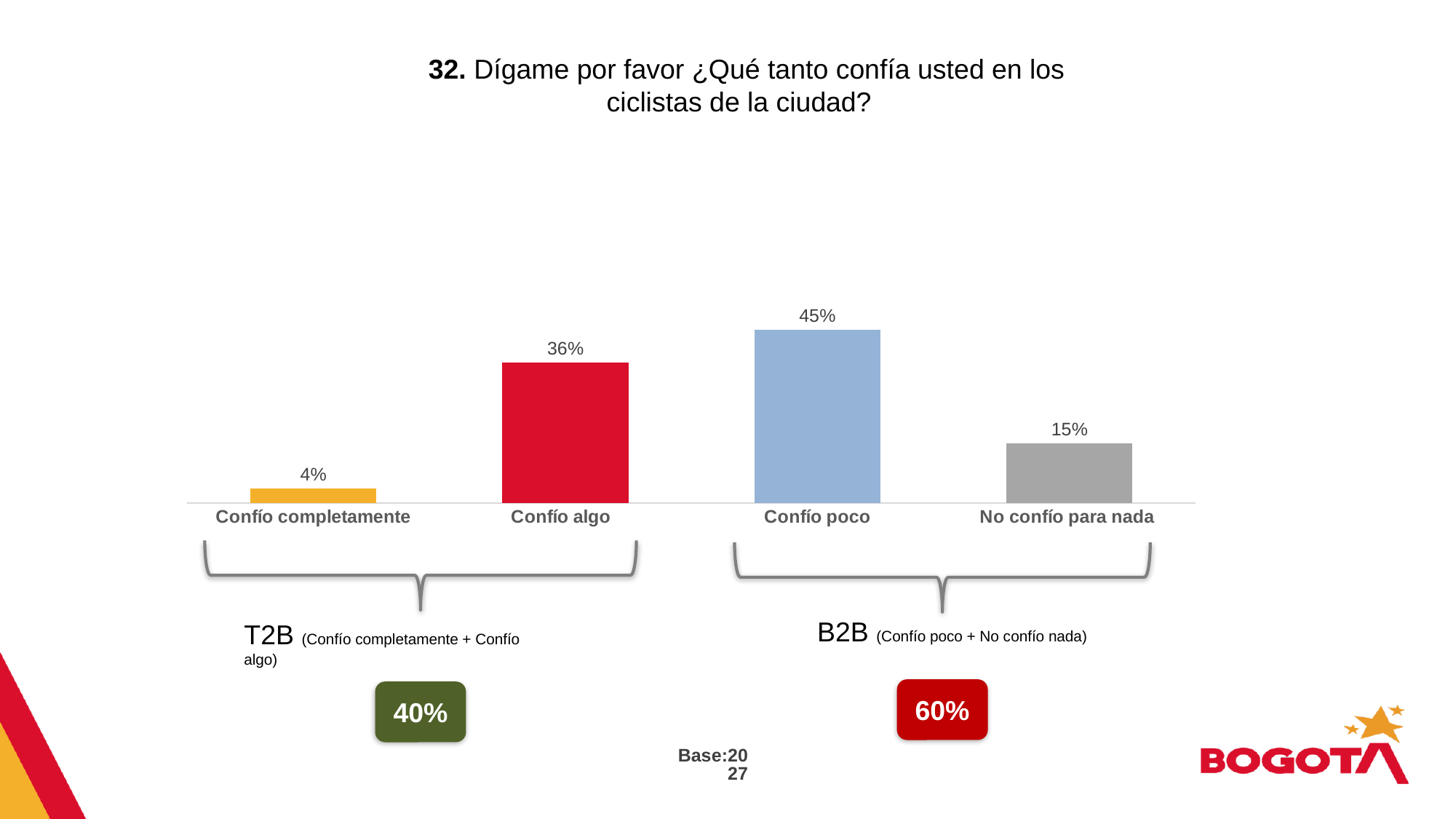
What is the T2B value (Confío completamente + Confío algo) shown on the slide? 40% What is the value for "Confío completamente"? 4% How many categories are shown in the chart? 4 Which category has the lowest value? Confío completamente What kind of chart is shown on the slide? Bar chart What is the value for "No confío para nada"? 15% Which category has the highest value? Confío poco What is the B2B value (Confío poco + No confío nada) shown on the slide? 60% What is the value for "Confío poco"? 45% What is the value for "Confío algo"? 36% What is the difference between the values for "Confío poco" and "Confío algo"? 9% Which is larger, the value for "Confío algo" or the value for "No confío para nada"? Confío algo